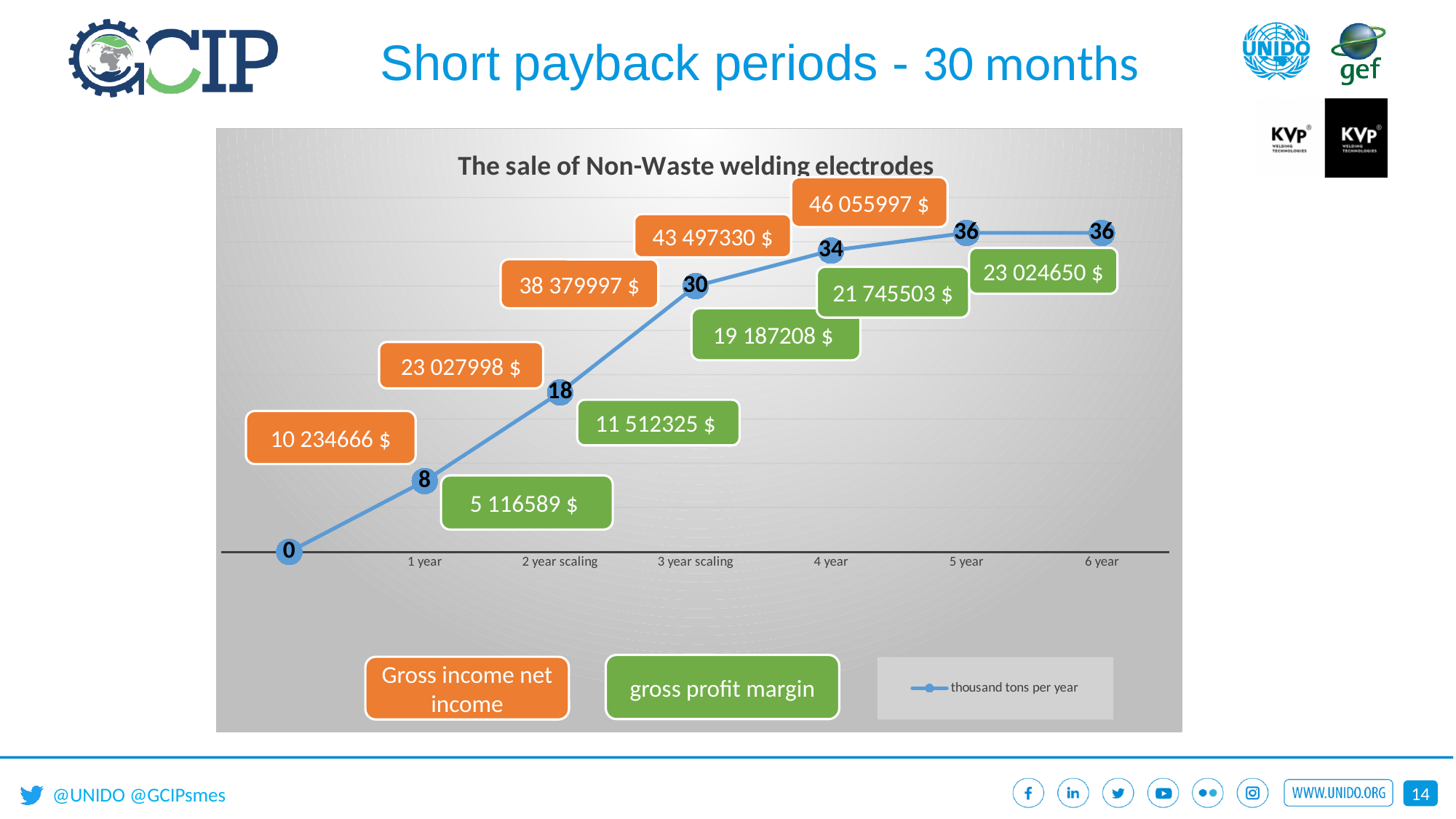
What is the title of the chart? The sale of Non-Waste welding electrodes What is the value plotted at 2 year scaling? 18 What kind of chart is shown on the slide? line chart What is the difference between the values at 3 year scaling and 2 year scaling? 12 What is the value plotted at 3 year scaling? 30 What is the value plotted at 1 year? 8 How many series does the legend list? 1 What is the value plotted at 4 year? 34 How many data points are plotted on the line? 7 What is the lowest value plotted on the line? 0 Do the plotted values rise or fall from the start to 6 year? rise Which is larger, the value at 4 year or the value at 2 year scaling? 4 year